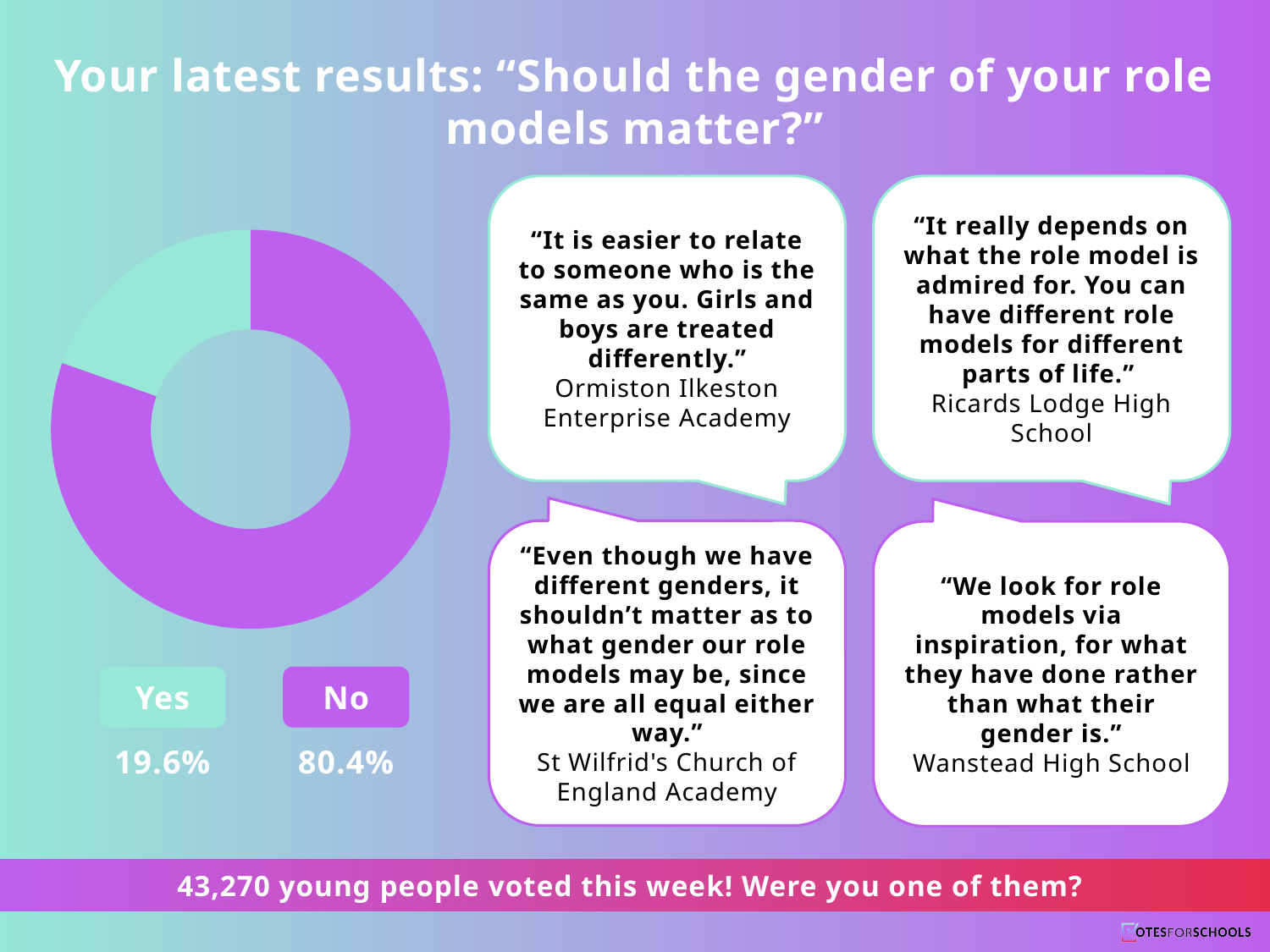
What colour represents the "No" response in the chart? Purple What colour represents the "Yes" response in the chart? Light green What percentage of respondents answered "No"? 80.4% How many categories does the chart show? 2 Which response received the larger share of votes? No Is the value for "No" greater or less than 50%? greater What is the difference in percentage points between the "No" and "Yes" responses? 60.8 What percentage of respondents answered "Yes"? 19.6% What is the total of the two percentages shown in the chart? 100% Is the share for "Yes" larger or smaller than the share for "No"? smaller Which response received the smaller share of votes? Yes What kind of chart is shown on the slide? Doughnut chart